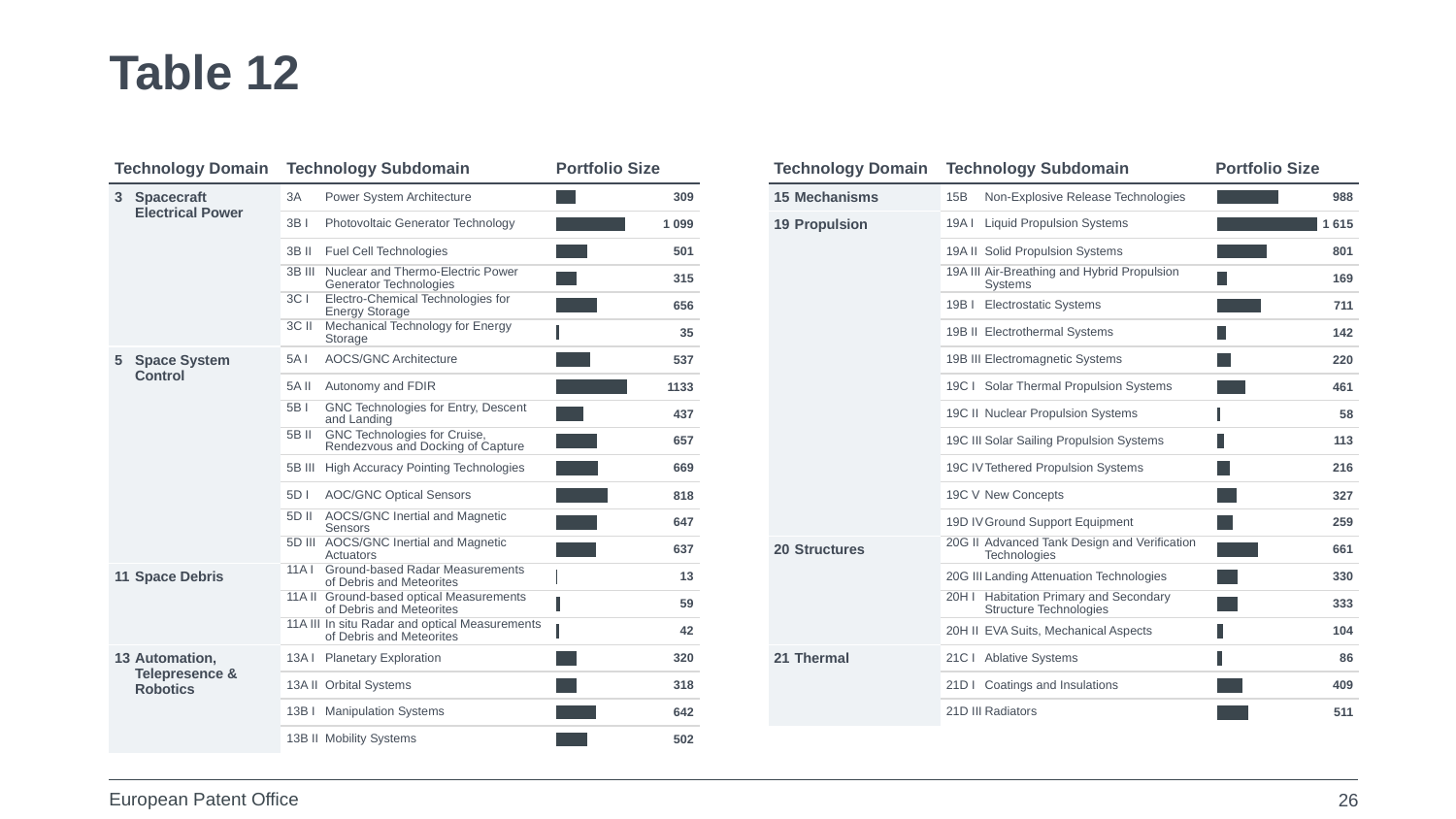
In the left table, which technology subdomain has the largest portfolio size? Autonomy and FDIR (5A II) In the right table, what is the portfolio size for Liquid Propulsion Systems (19A I)? 1 615 In the right table, which technology subdomain has the smallest portfolio size? Nuclear Propulsion Systems (19C II) What kind of chart is used to show the Portfolio Size values in the tables? Bar chart In the right table, how many technology subdomains are listed under the Propulsion domain? 12 In the left table, which technology subdomain has the smallest portfolio size? Ground-based Radar Measurements of Debris and Meteorites (11A I) In the right table, what is the difference in portfolio size between Non-Explosive Release Technologies (15B) and Solid Propulsion Systems (19A II)? 187 In the left table, what is the portfolio size for Photovoltaic Generator Technology (3B I)? 1 099 In the left table, what is the portfolio size for Mechanical Technology for Energy Storage (3C II)? 35 In the left table, how many technology subdomains are listed under the Space System Control domain? 8 In the left table, which has a larger portfolio size: Manipulation Systems (13B I) or Mobility Systems (13B II)? Manipulation Systems (13B I) In the right table, which has a larger portfolio size: Electrostatic Systems (19B I) or Solar Thermal Propulsion Systems (19C I)? Electrostatic Systems (19B I)